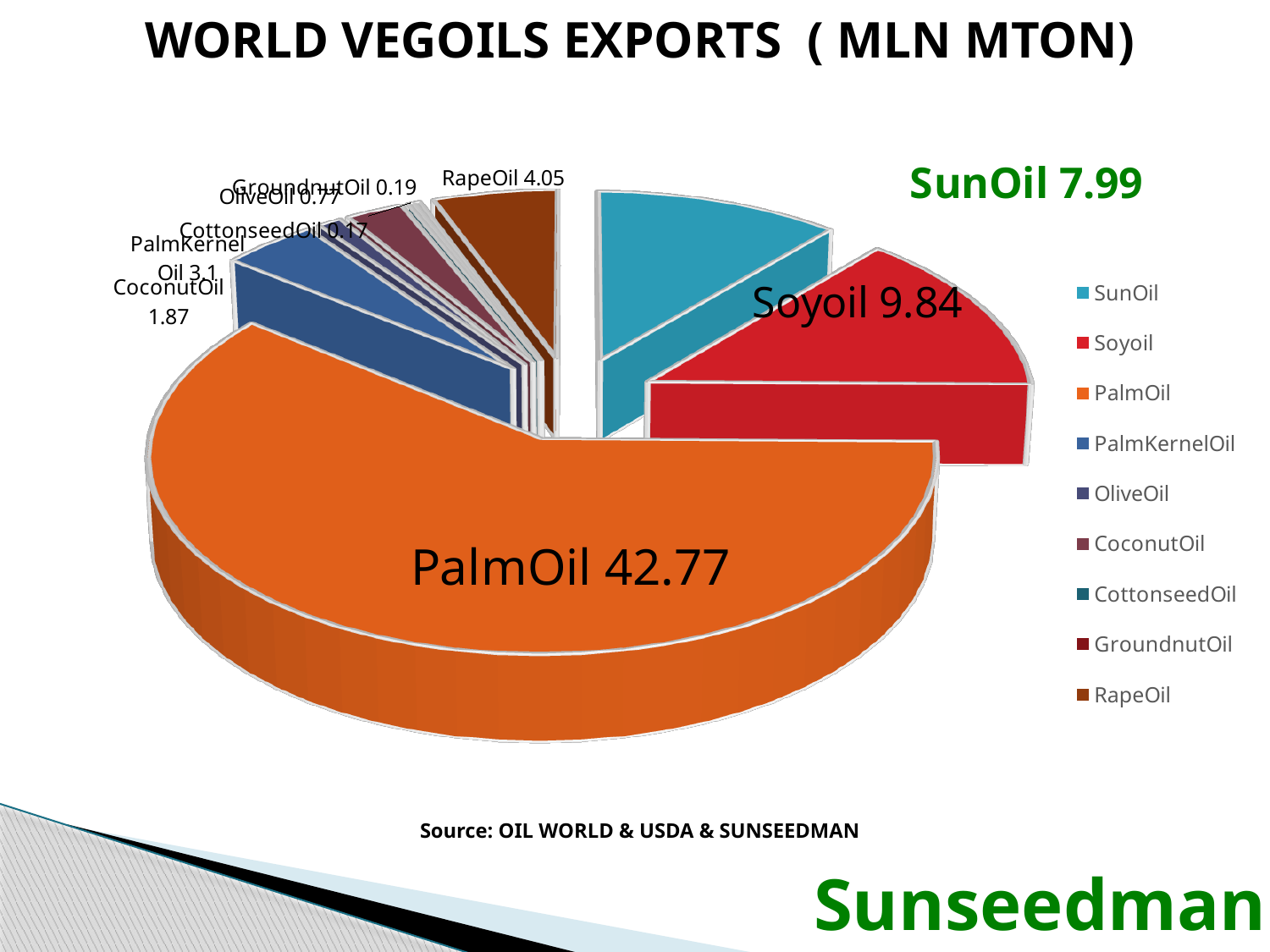
What is the value for RapeOil in the pie chart? 4.05 Which oil has the smallest value in the pie chart? CottonseedOil What is the value for PalmOil in the pie chart? 42.77 What is the value for SunOil in the pie chart? 7.99 Which oil has the largest slice in the pie chart? PalmOil What kind of chart is shown on the slide? pie chart What is the value for Soyoil in the pie chart? 9.84 How many categories does the legend of the pie chart list? 9 What is the title of the chart? WORLD VEGOILS EXPORTS ( MLN MTON) What is the difference between the Soyoil and SunOil values? 1.85 Which is larger, RapeOil or PalmKernelOil? RapeOil What is the value for CoconutOil in the pie chart? 1.87